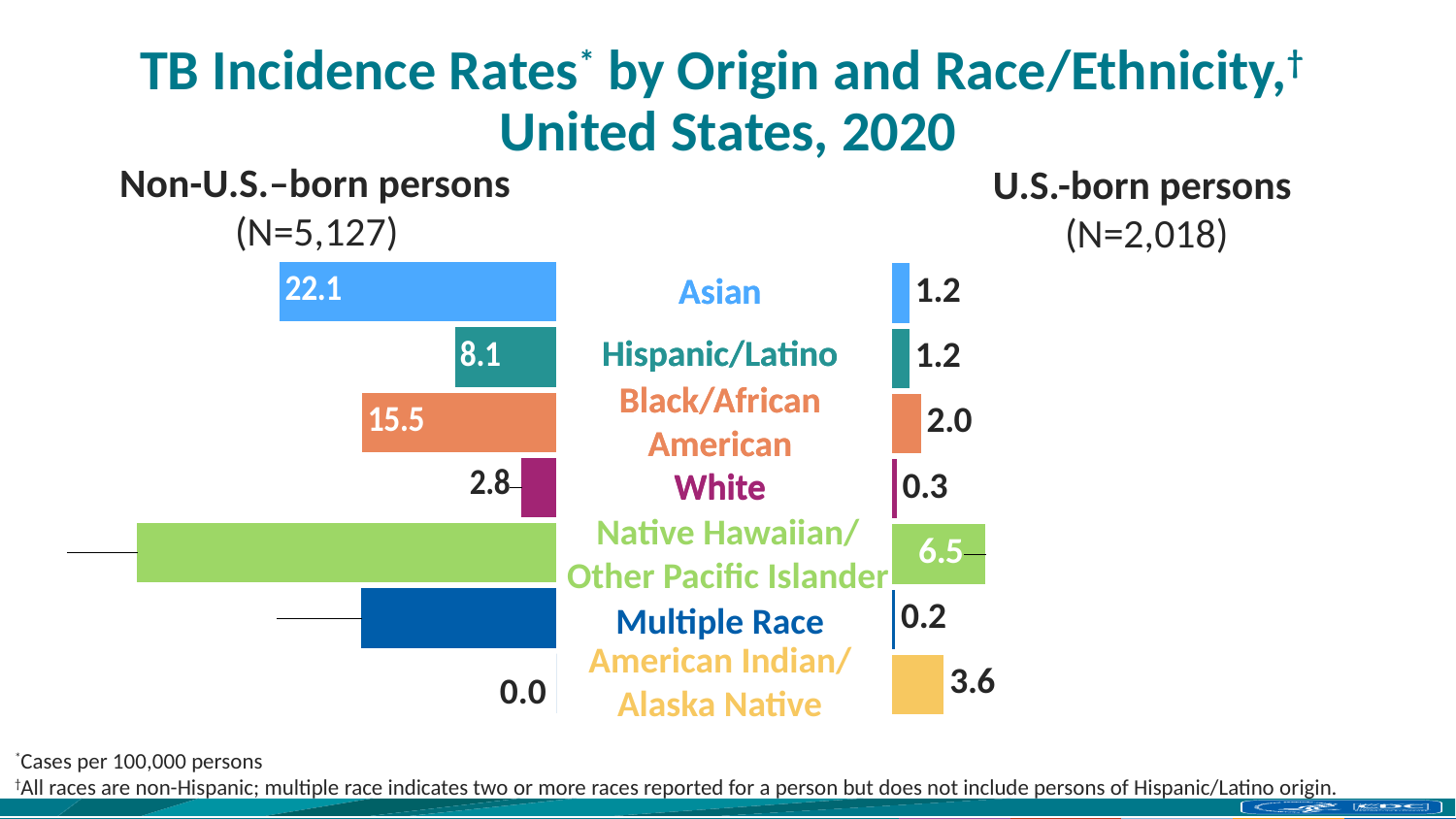
On the U.S.-born persons chart, which race/ethnicity group has the highest TB incidence rate? Native Hawaiian/Other Pacific Islander On the U.S.-born persons chart, what is the TB incidence rate for American Indian/Alaska Native persons? 3.6 On the U.S.-born persons chart, what is the difference between the TB incidence rates for Black/African American and White persons? 1.7 On the U.S.-born persons chart, which race/ethnicity group has the lowest TB incidence rate? Multiple Race What type of chart is used on this slide? Bar chart How many race/ethnicity categories are shown on the slide's charts? 7 On the Non-U.S.-born persons chart, which is larger: the rate for Black/African American persons or the rate for Hispanic/Latino persons? Black/African American On the U.S.-born persons chart, what is the TB incidence rate for Native Hawaiian/Other Pacific Islander persons? 6.5 On the Non-U.S.-born persons chart, what is the TB incidence rate for Black/African American persons? 15.5 On the Non-U.S.-born persons chart, what is the TB incidence rate for Asian persons? 22.1 On the Non-U.S.-born persons chart, which race/ethnicity group has the lowest TB incidence rate? American Indian/Alaska Native On the Non-U.S.-born persons chart, what is the difference between the TB incidence rates for Asian and Hispanic/Latino persons? 14.0